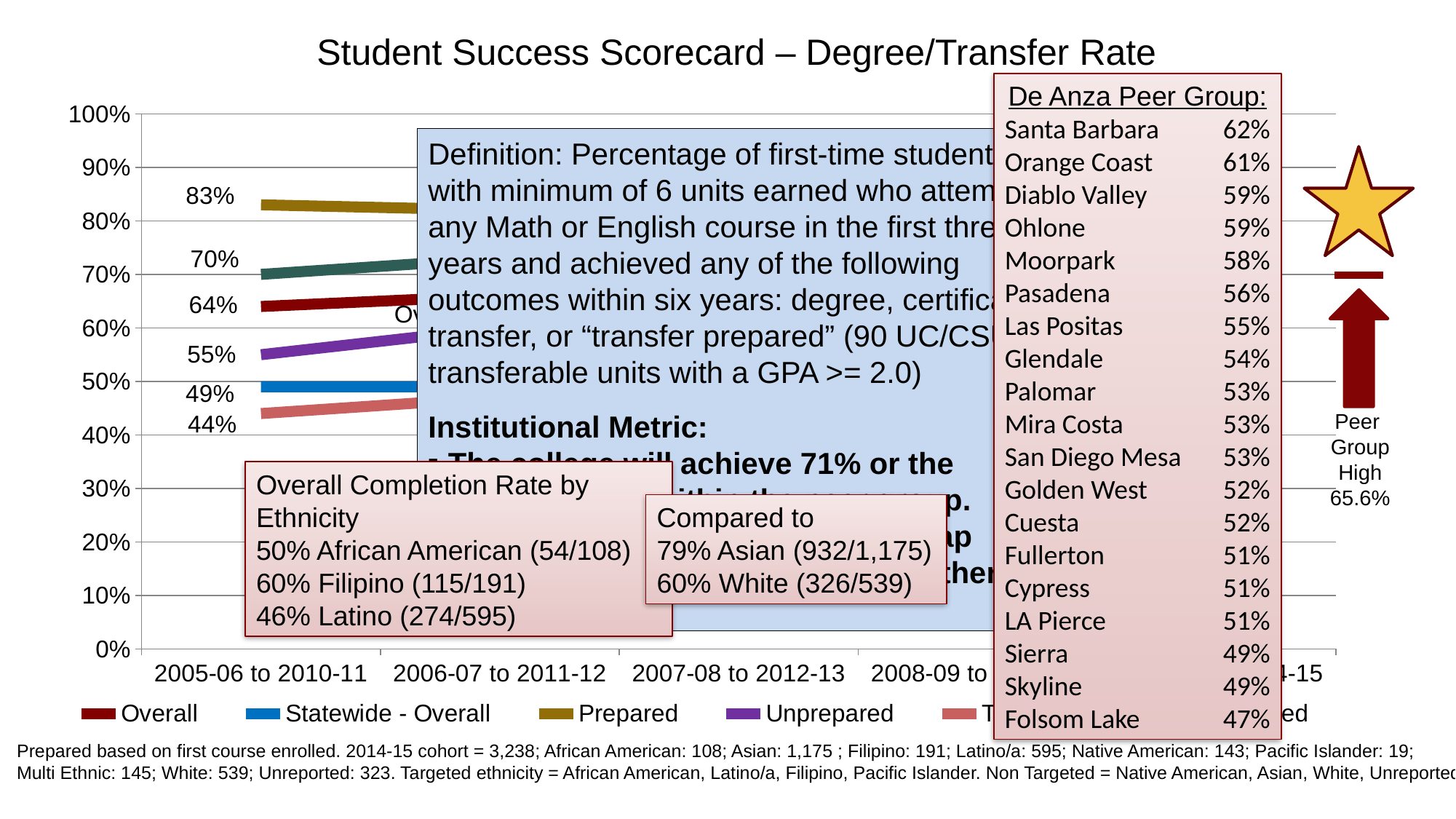
For the 2005-06 to 2010-11 cohort, how much higher is the Prepared value than the Overall value? 19 percentage points What is the value of the Unprepared series for the 2005-06 to 2010-11 cohort? 55% What is the title of the slide's chart? Student Success Scorecard – Degree/Transfer Rate Which series has the highest value for the 2005-06 to 2010-11 cohort? Prepared What is the value of the Overall series for the 2005-06 to 2010-11 cohort? 64% What is the value of the Statewide - Overall series for the 2005-06 to 2010-11 cohort? 49% Is the Overall value for the 2005-06 to 2010-11 cohort greater or less than 60%? greater What is the value of the Prepared series for the 2005-06 to 2010-11 cohort? 83% What kind of chart is shown on the slide? Line chart What is the lowest value labeled on the chart for the 2005-06 to 2010-11 cohort? 44% For the 2005-06 to 2010-11 cohort, which is larger: Overall or Statewide - Overall? Overall For the 2005-06 to 2010-11 cohort, what is the difference between the Overall value and the Statewide - Overall value? 15 percentage points